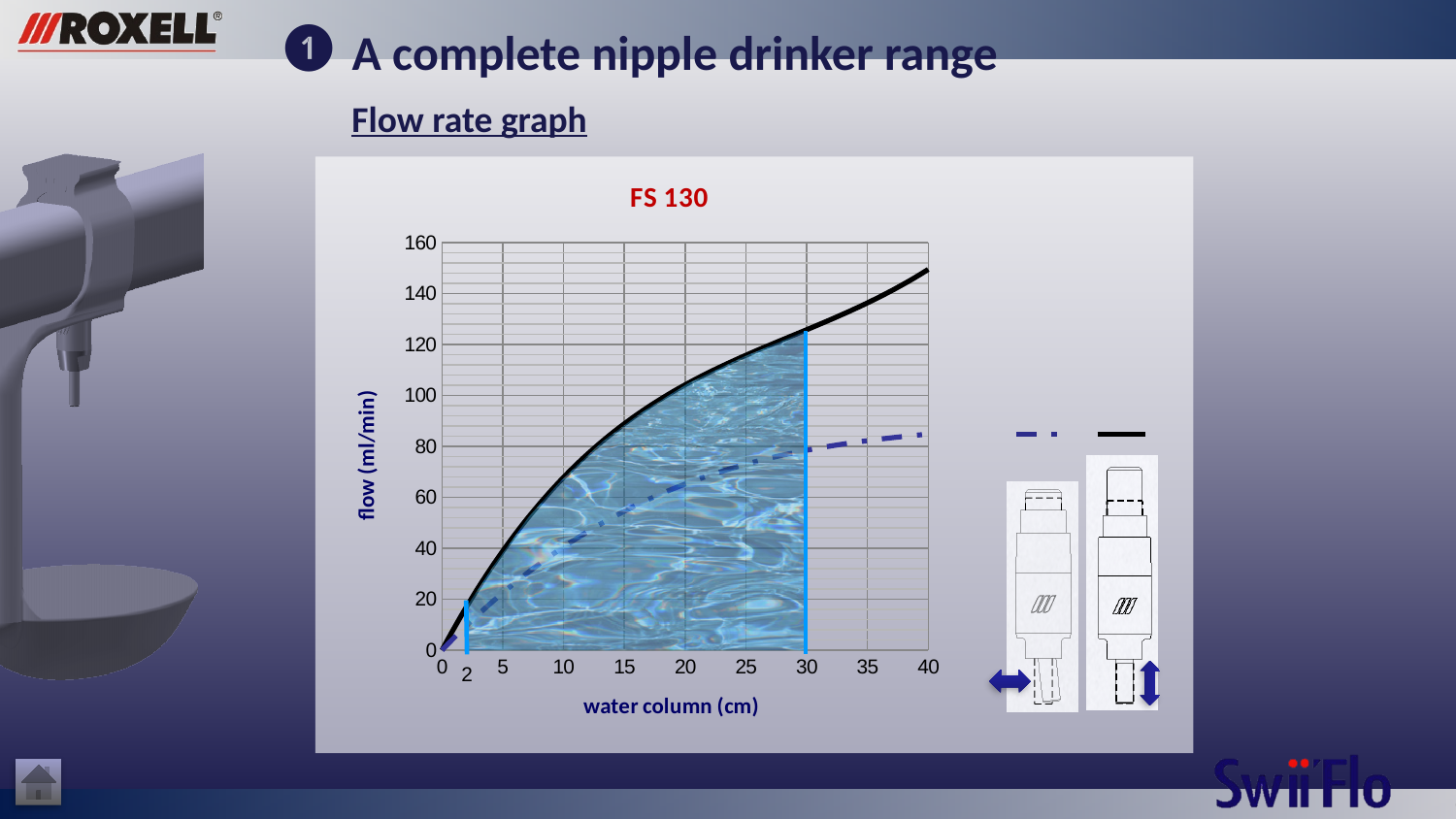
Is the value of the dash-dot blue line at a water column of 40 cm greater or less than 100 ml/min? less How many series does the chart's legend list? 2 Does the dash-dot blue line rise or fall as the water column increases? rise Does the solid black line rise or fall as the water column increases? rise What kind of chart is shown on the slide? line chart What is the title of the chart? FS 130 Is the value of the dash-dot blue line at a water column of 20 cm greater or less than 80 ml/min? less At a water column of 30 cm, which line shows the higher flow: the solid black line or the dash-dot blue line? the solid black line What is the highest value shown on the y axis of the chart? 160 Is the value of the solid black line at a water column of 30 cm greater or less than 100 ml/min? greater What is the label of the x axis of the chart? water column (cm)